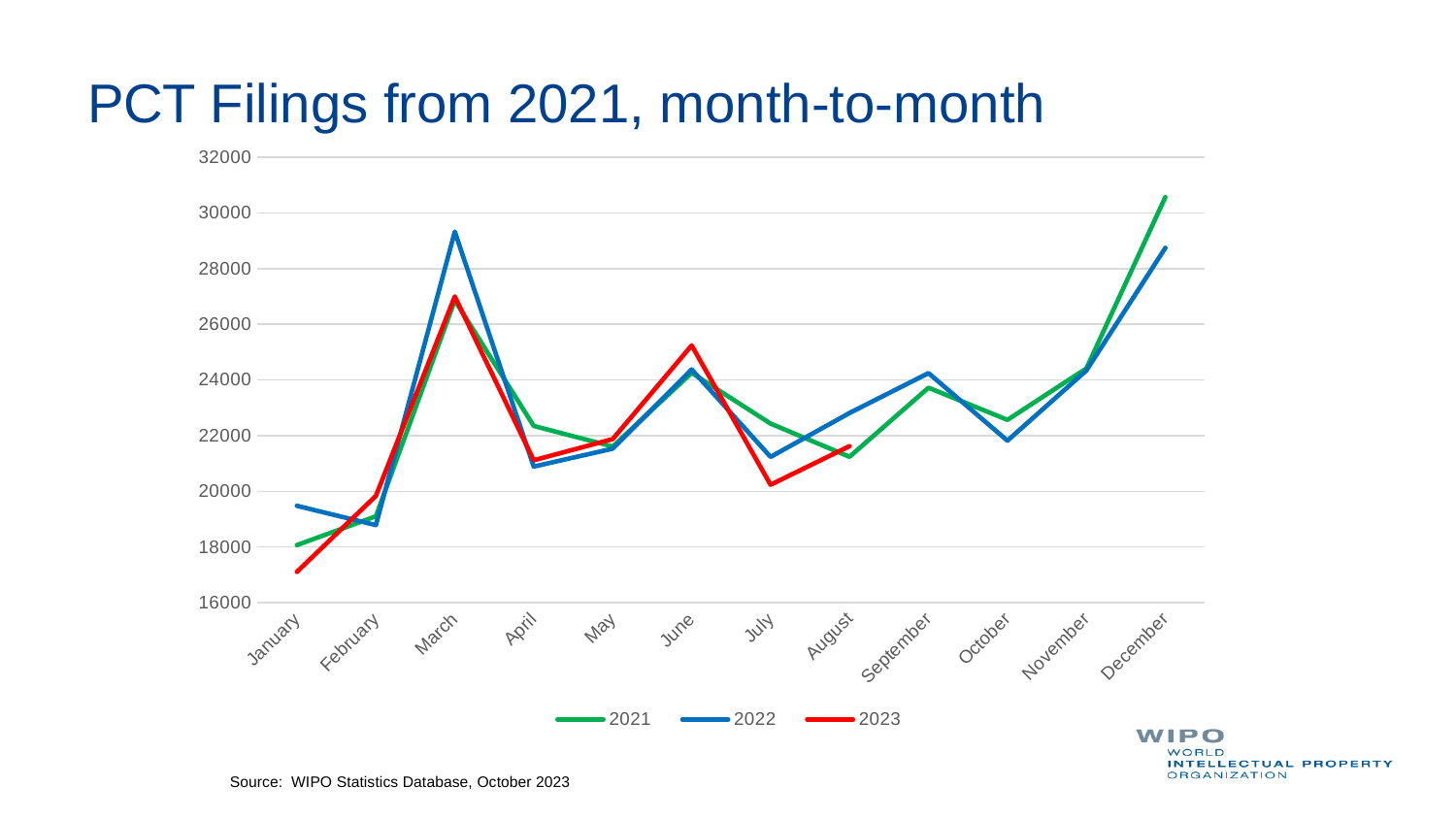
In which month does the 2021 series reach its highest value? December Does the 2023 series rise or fall from January to March? Rise Is the value for 2022 in March greater or less than 28000? greater Is the value for 2023 in January greater or less than 18000? less In which month does the 2022 series reach its highest value? March What kind of chart is shown on the slide? Line chart What colour is the line for the 2023 series? Red In which month is the 2023 series at its lowest value? January Is the value for 2023 in July greater or less than 22000? less How many months are shown along the x axis? 12 How many series does the legend list? 3 Which series has the larger value in December, 2021 or 2022? 2021